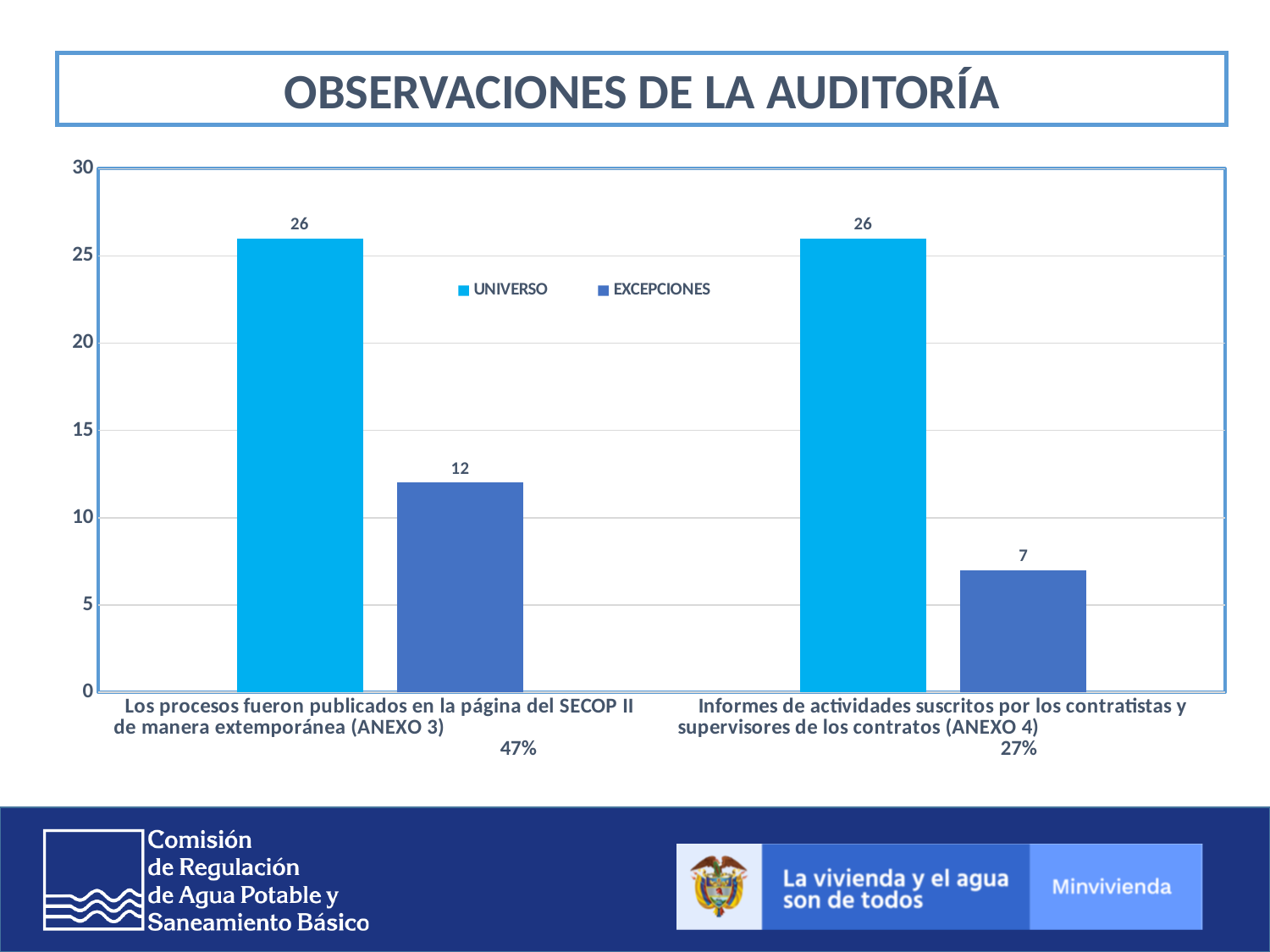
What is the difference between the EXCEPCIONES values of the ANEXO 3 and ANEXO 4 categories? 5 What percentage is printed under the ANEXO 4 category label? 27% Is the EXCEPCIONES value for the ANEXO 4 category greater or less than 10? less How many series does the legend list? 2 What kind of chart is shown on the slide? Bar chart How many categories are shown on the x axis? 2 Which category has the lower EXCEPCIONES value? Informes de actividades suscritos por los contratistas y supervisores de los contratos (ANEXO 4) What is the EXCEPCIONES value for the category 'Informes de actividades suscritos por los contratistas y supervisores de los contratos (ANEXO 4)'? 7 What is the difference between the UNIVERSO and EXCEPCIONES values for the ANEXO 3 category? 14 Which is larger: the EXCEPCIONES value for ANEXO 3 or the EXCEPCIONES value for ANEXO 4? ANEXO 3 What is the EXCEPCIONES value for the ANEXO 3 category? 12 What is the UNIVERSO value for the category 'Los procesos fueron publicados en la página del SECOP II de manera extemporánea (ANEXO 3)'? 26